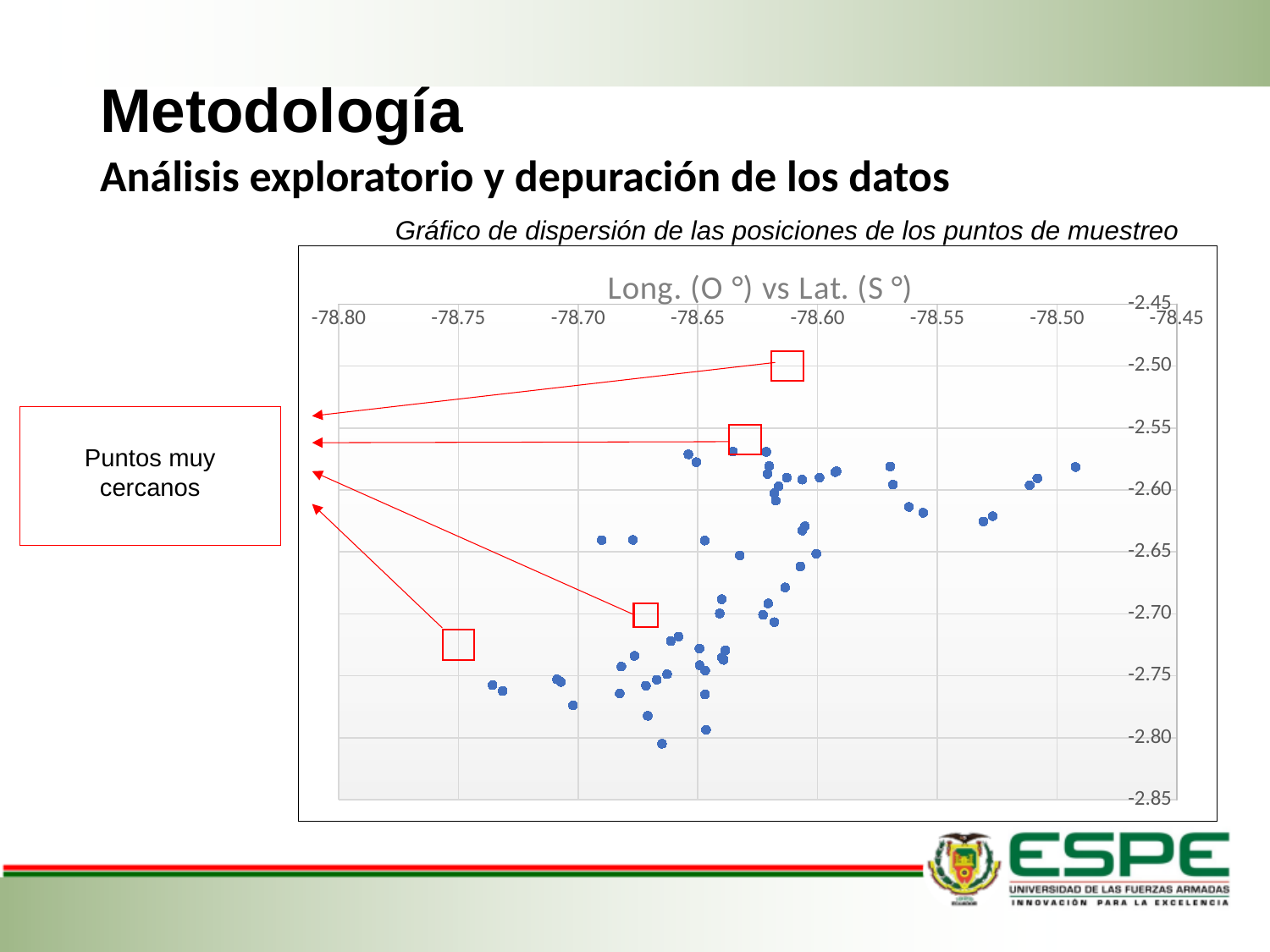
Is the latitude of the highest plotted point on the chart greater or less than -2.60? greater Is the longitude of the rightmost plotted point on the chart greater or less than -78.55? greater Is the longitude of the leftmost plotted point on the chart greater or less than -78.70? less What is the title of the chart? Long. (O °) vs Lat. (S °) What kind of chart is shown on the slide? scatter chart How many red boxes highlighting groups of points are drawn on the chart? 4 What is the leftmost tick label on the horizontal axis of the chart? -78.80 What label does the text box to the left of the chart give to the highlighted points? Puntos muy cercanos